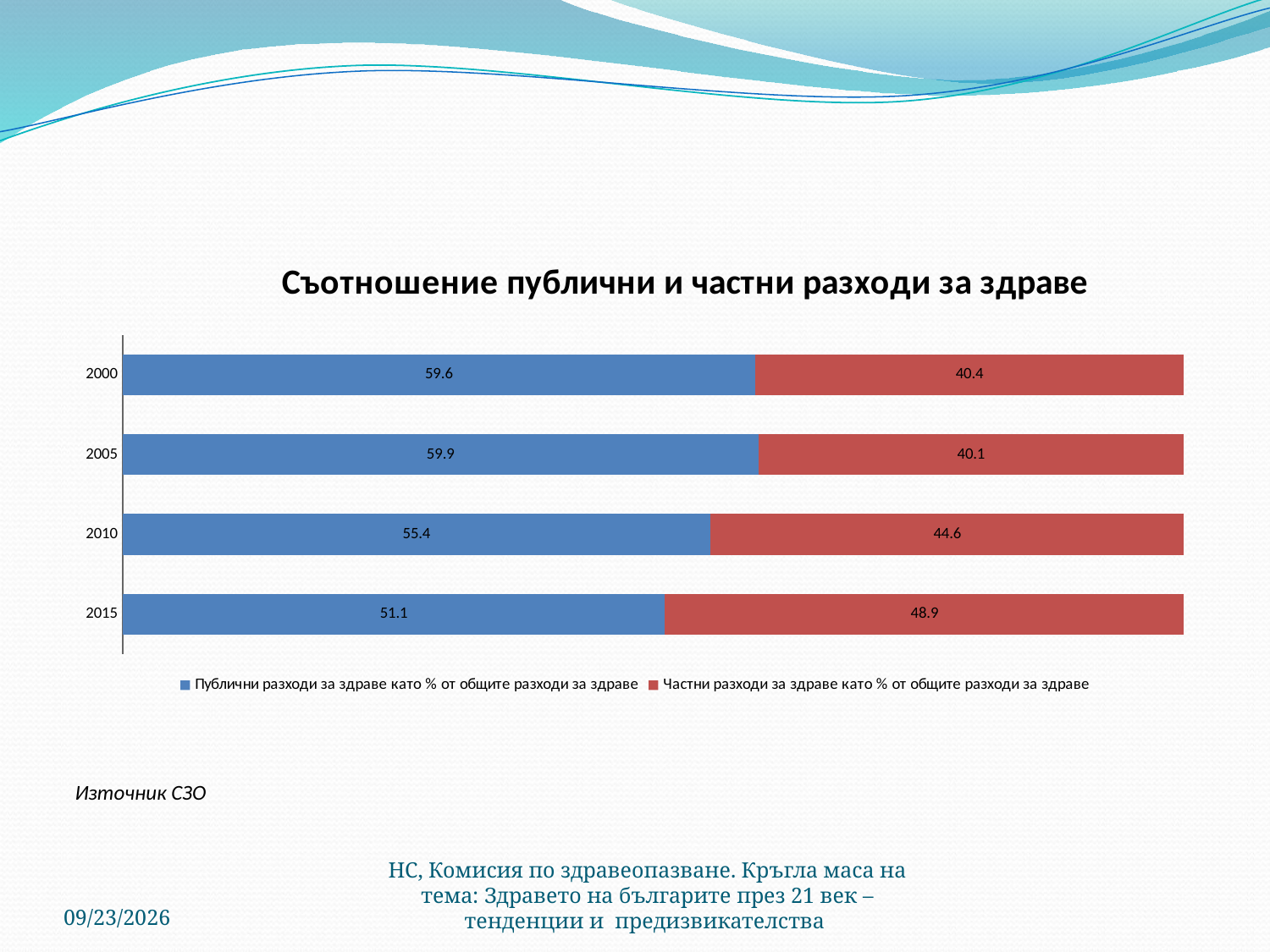
What kind of chart is shown on the slide? Stacked horizontal bar chart What is the value of public health expenditure (Публични разходи за здраве) as % of total for 2015? 51.1 How many years (categories) are shown on the chart? 4 What is the title of the chart? Съотношение публични и частни разходи за здраве What is the value of public health expenditure as % of total for 2000? 59.6 How does the private health expenditure share change from 2005 to 2015? It rises Which is larger in 2010: the public expenditure share or the private expenditure share? Public expenditure share (55.4) What is the value of private health expenditure (Частни разходи за здраве) as % of total for 2010? 44.6 In which year is the public health expenditure share the highest? 2005 What is the difference between the public and private expenditure shares in 2015? 2.2 How many series does the legend list? 2 In which year is the private health expenditure share the lowest? 2005